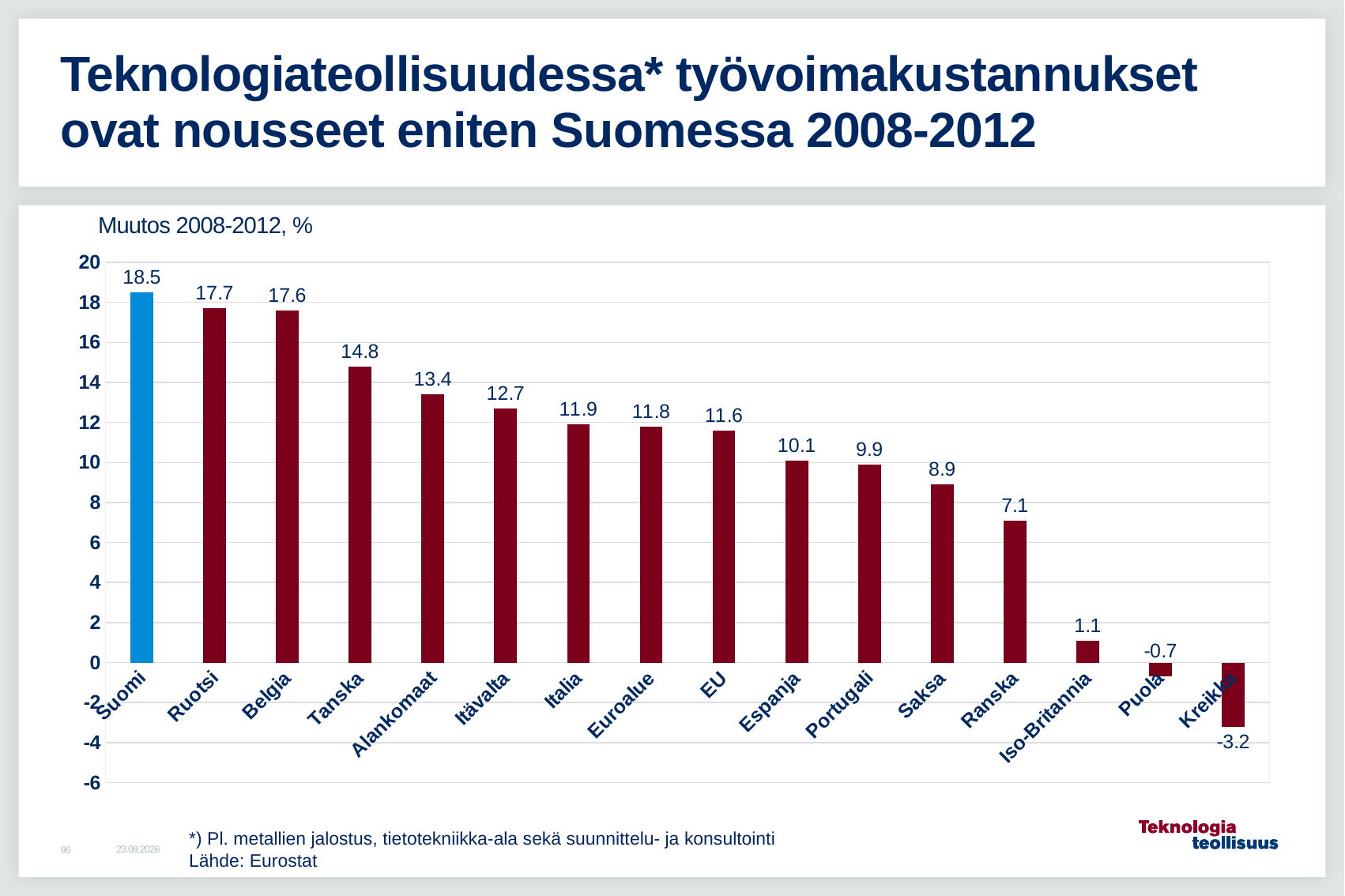
How many categories are shown on the x axis? 16 What is the value for Kreikka? -3.2 Is the value for Ranska greater or less than 8? less What is the value for Suomi? 18.5 Do the values rise or fall from left to right along the x axis? fall Which country has the lowest value? Kreikka What is the value for Saksa? 8.9 What kind of chart is shown on the slide? bar chart What is the difference between the values for Suomi and Ruotsi? 0.8 Which country has the highest value? Suomi Which bar is coloured differently from the others? Suomi Which is larger, the value for Tanska or the value for Alankomaat? Tanska